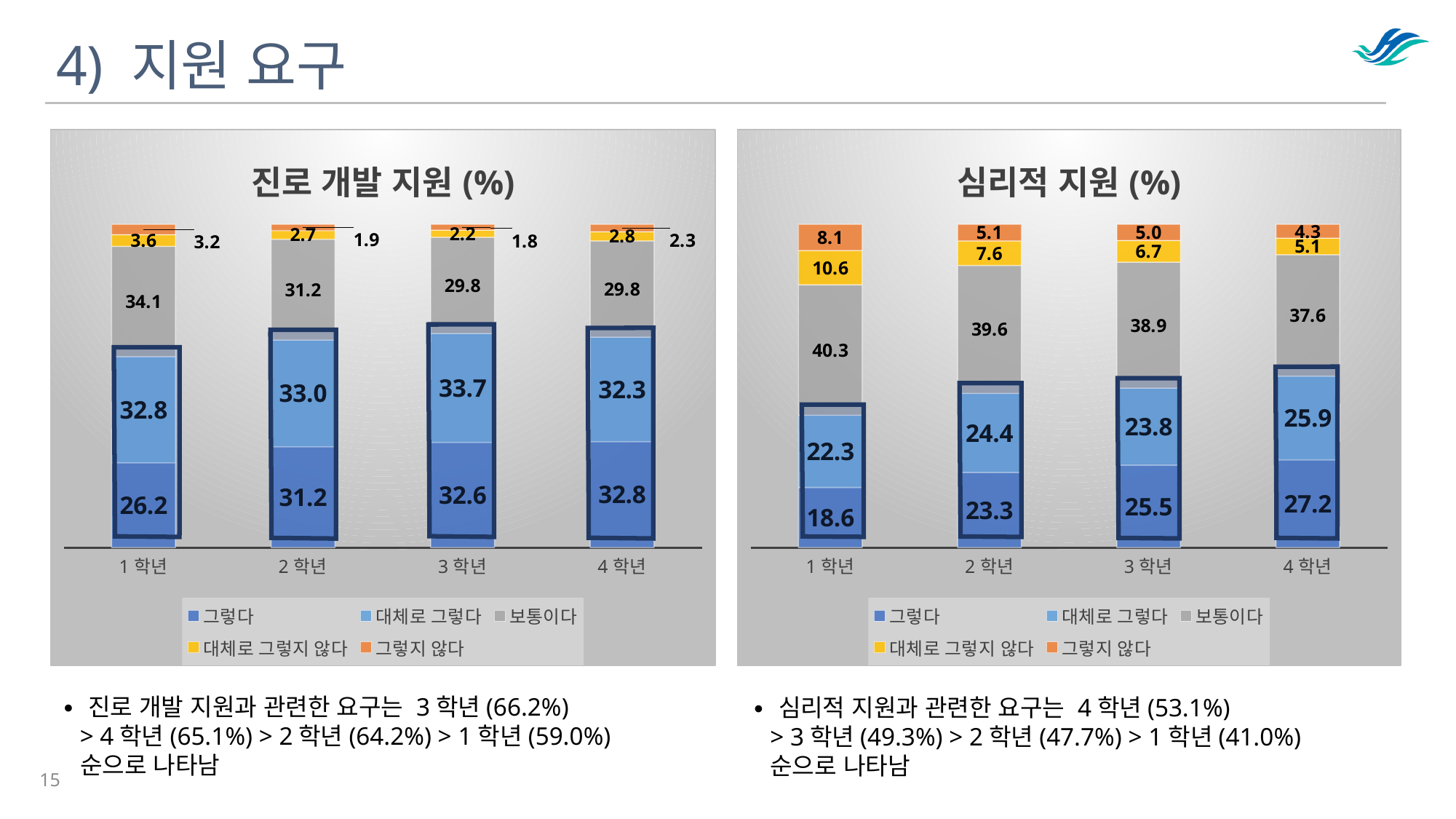
How many grade categories are shown on the x axis of the 진로 개발 지원 (%) chart? 4 In the 진로 개발 지원 (%) chart, which is larger: 그렇다 for 2 학년 or 그렇다 for 4 학년? 4 학년 In the 심리적 지원 (%) chart, what is the value of 보통이다 for 2 학년? 39.6 How many series does the legend of the 심리적 지원 (%) chart list? 5 In the 진로 개발 지원 (%) chart, which grade has the highest value for 대체로 그렇다? 3 학년 In the 심리적 지원 (%) chart, what is the difference between the 보통이다 values for 1 학년 and 4 학년? 2.7 In the 심리적 지원 (%) chart, which grade has the lowest value for 그렇다? 1 학년 In the 심리적 지원 (%) chart, what is the value of 그렇지 않다 for 1 학년? 8.1 In the 진로 개발 지원 (%) chart, what is the value of 그렇다 for 1 학년? 26.2 In the 심리적 지원 (%) chart, what is the combined value of 그렇다 and 대체로 그렇다 for 4 학년? 53.1 What type of chart is the 진로 개발 지원 (%) chart? Stacked bar chart In the 심리적 지원 (%) chart, does the value of 그렇다 rise or fall from 1 학년 to 4 학년? Rise